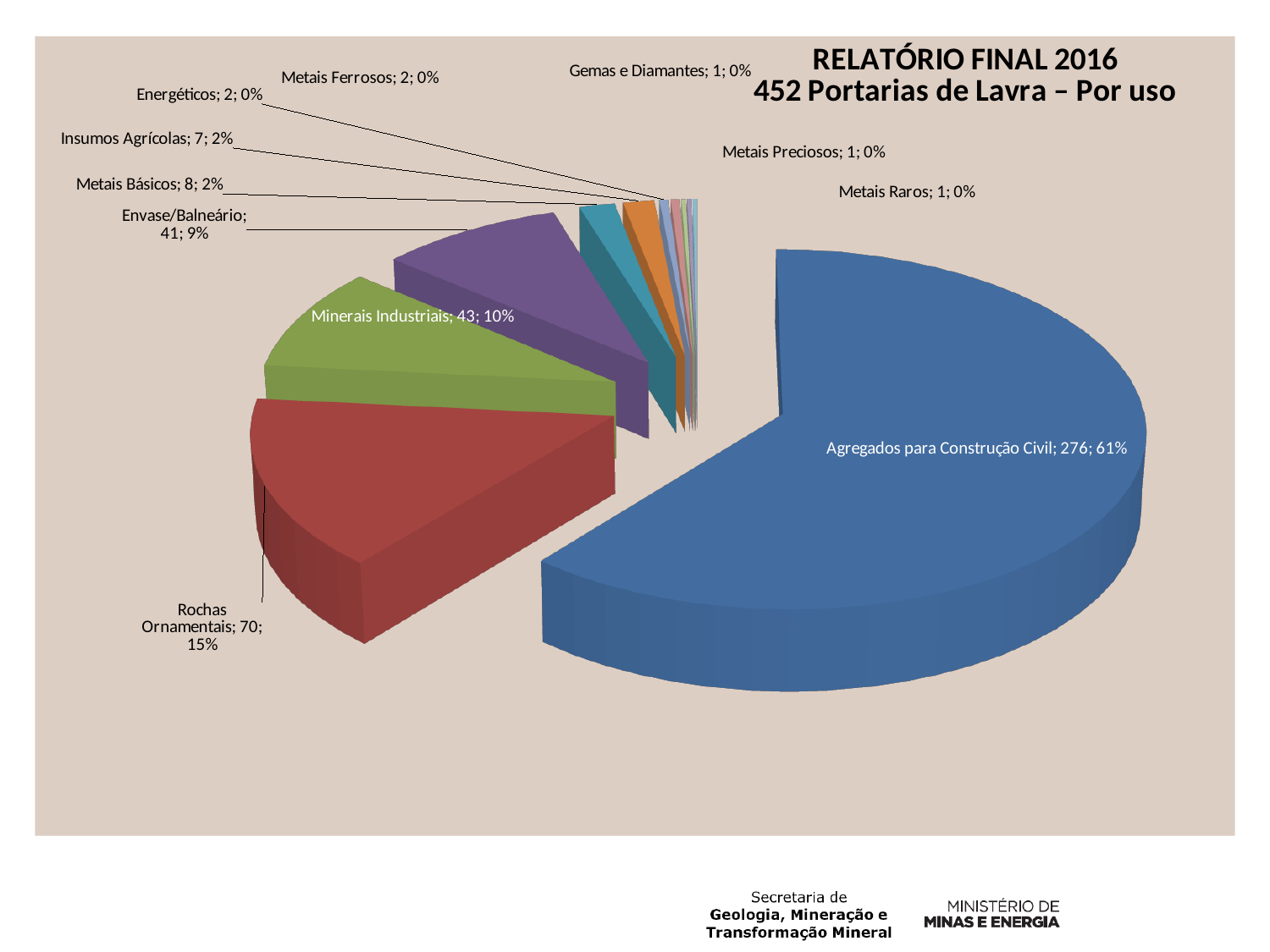
What percentage is shown for Minerais Industriais? 10% Which is larger, the value for Metais Básicos or the value for Insumos Agrícolas? Metais Básicos What is the difference between the values for Rochas Ornamentais and Minerais Industriais? 27 What kind of chart is shown on the slide? Pie chart What is the title of the chart? RELATÓRIO FINAL 2016 452 Portarias de Lavra – Por uso How many Portarias de Lavra are shown for Agregados para Construção Civil? 276 What share of the pie does Agregados para Construção Civil represent? 61% How many Portarias de Lavra are shown for Rochas Ornamentais? 70 Which category has the largest slice of the pie? Agregados para Construção Civil What value is shown for Envase/Balneário? 41 What percentage is shown for Gemas e Diamantes? 0% How many categories are shown in the pie chart? 11